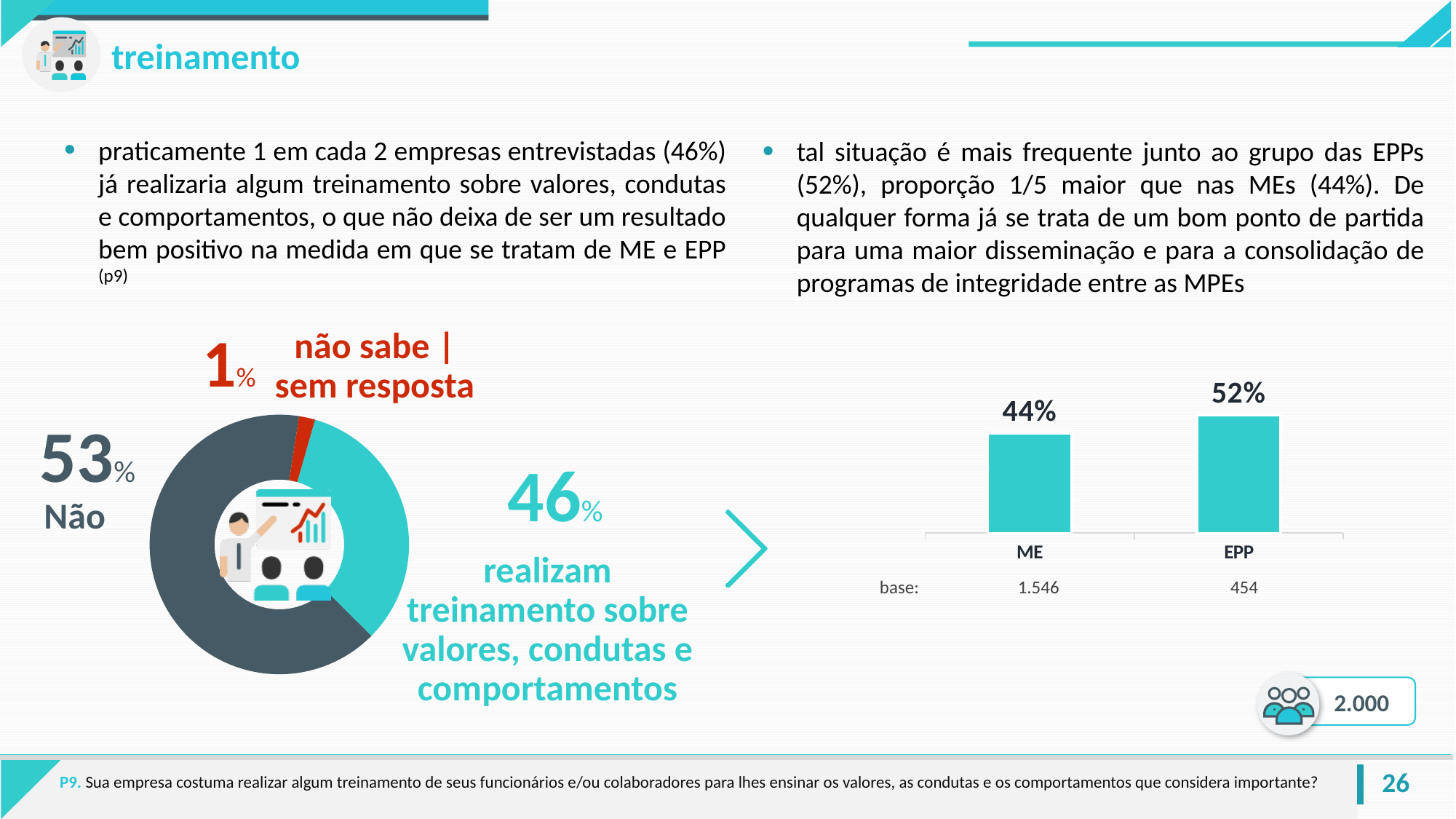
In the bar chart on the right, what is the difference between the EPP and ME values? 8% In the bar chart on the right, what is the value for ME? 44% In the pie chart on the left, what is the difference between the "Não" share and the share that realizam treinamento? 7% In the pie chart on the left, what share of companies answered "Não"? 53% In the bar chart on the right, what is the value for EPP? 52% In the bar chart on the right, which category has the higher value, ME or EPP? EPP In the pie chart on the left, what share of companies realizam treinamento sobre valores, condutas e comportamentos? 46% In the pie chart on the left, what share is "não sabe | sem resposta"? 1% In the pie chart on the left, how many slices are there? 3 In the pie chart on the left, which category has the largest share? Não What kind of chart is shown on the right side of the slide? Bar chart In the pie chart on the left, which category has the smallest share? não sabe | sem resposta